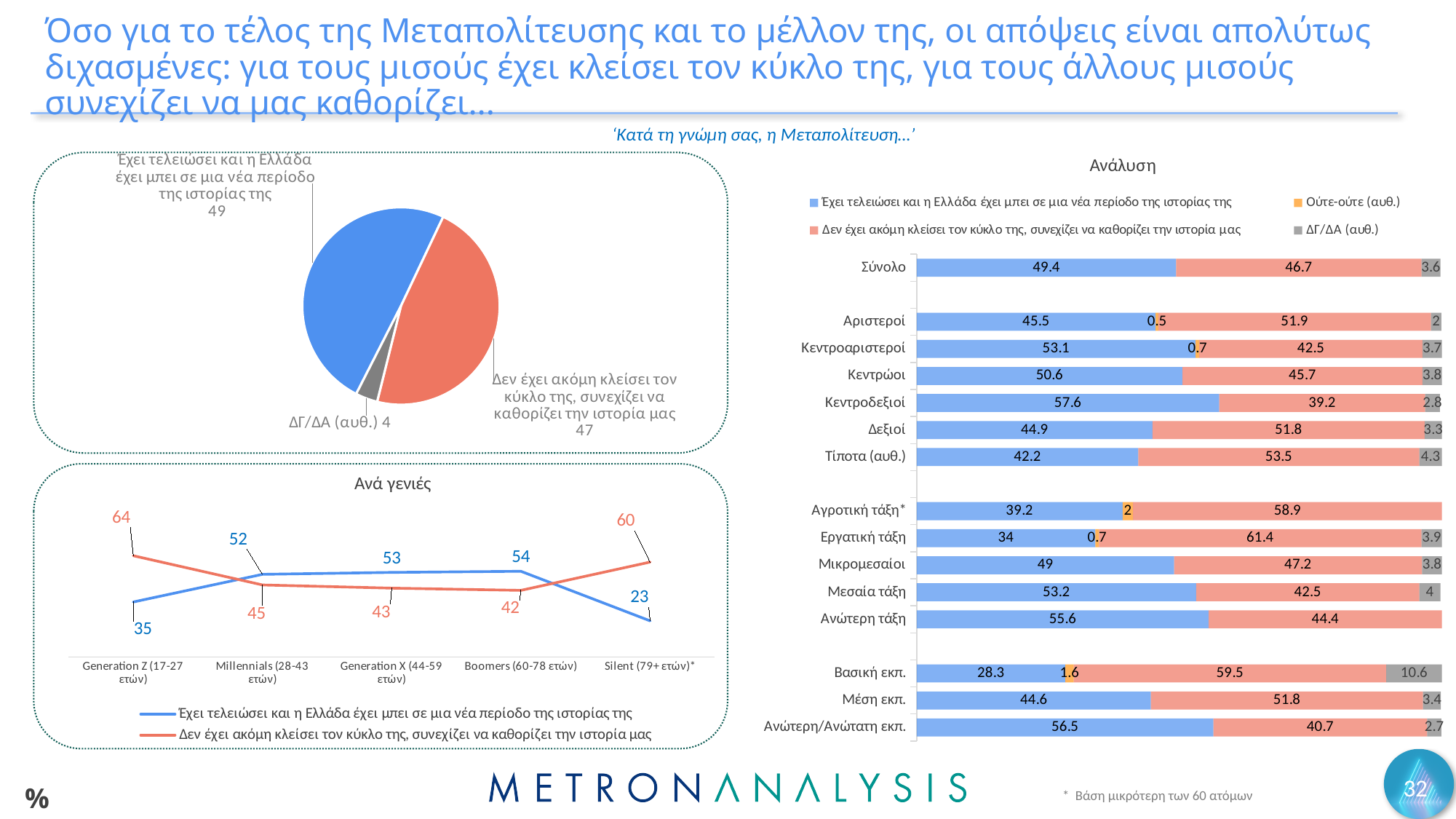
In the 'Ανά γενιές' chart, what is the difference between the blue and red values for Boomers (60-78 ετών)? 12 In the 'Ανάλυση' chart, which category has the highest value for the blue series 'Έχει τελειώσει...'? Κεντροδεξιοί In the 'Ανά γενιές' chart, how many generation categories are shown on the x axis? 5 In the 'Ανάλυση' chart, which is larger for Εργατική τάξη: the blue value or the red value? the red value (61.4) In the top-left pie chart, what share is shown for 'Έχει τελειώσει και η Ελλάδα έχει μπει σε μια νέα περίοδο της ιστορίας της'? 49 In the 'Ανάλυση' chart, what is the value of 'ΔΓ/ΔΑ (αυθ.)' (grey) for Βασική εκπ.? 10.6 What kind of chart is the top-left chart on the slide? pie chart In the 'Ανά γενιές' chart, what is the value of the red series ('Δεν έχει ακόμη κλείσει τον κύκλο της...') for Generation Z (17-27 ετών)? 64 In the 'Ανά γενιές' chart, which generation has the lowest value for the blue series ('Έχει τελειώσει...')? Silent (79+ ετών)* In the top-left pie chart, what value is shown for 'ΔΓ/ΔΑ (αυθ.)'? 4 In the 'Ανάλυση' chart, what is the value of 'Έχει τελειώσει...' (blue) for Σύνολο? 49.4 In the 'Ανάλυση' chart, how many series does the legend list? 4